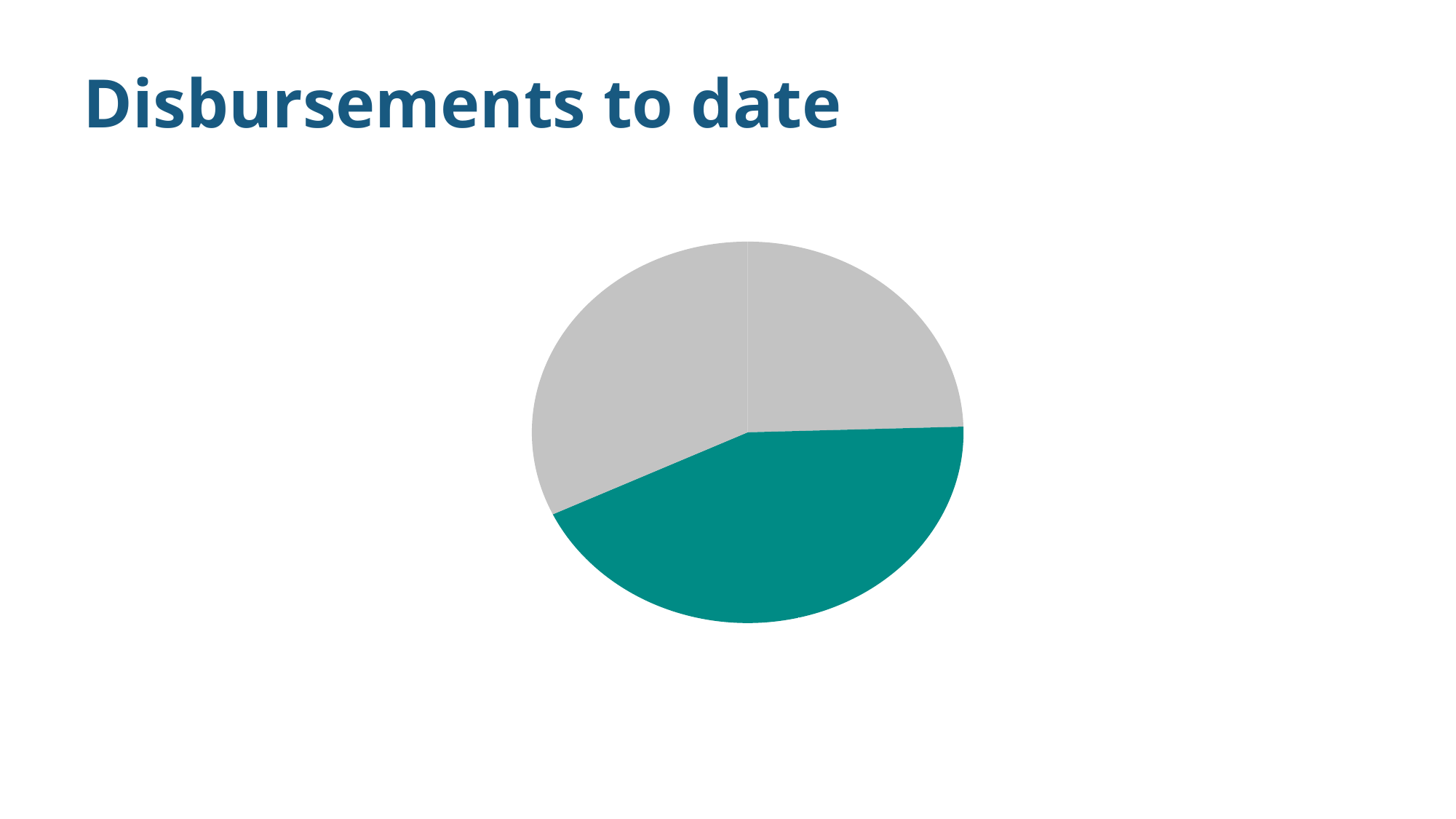
How many slices does the pie chart have? 3 What kind of chart is shown on the slide? pie chart What is the title of the slide containing the pie chart? Disbursements to date Which slice of the pie chart is the largest? the teal slice Does the pie chart display a legend? No Which slice of the pie chart is the smallest? the upper-right grey slice